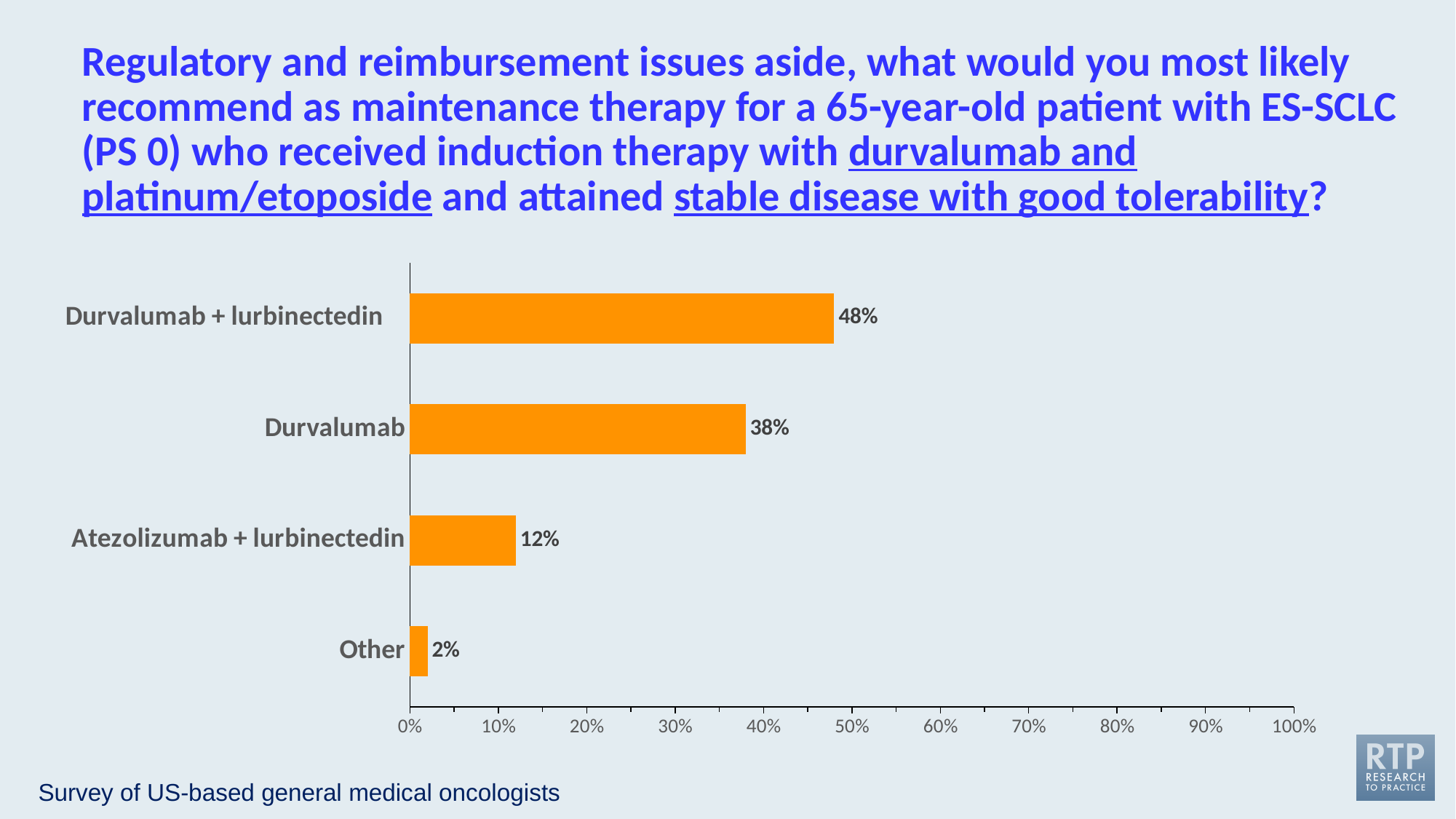
What is the difference in percentage points between Durvalumab and Atezolizumab + lurbinectedin? 26 How many answer options are shown in the chart? 4 Which option has the highest percentage of respondents? Durvalumab + lurbinectedin Which has a larger share of respondents, Durvalumab or Atezolizumab + lurbinectedin? Durvalumab What type of chart is shown on the slide? Bar chart What percentage of respondents would recommend Atezolizumab + lurbinectedin? 12% What is the difference in percentage points between Durvalumab + lurbinectedin and Durvalumab? 10 What is the maximum value shown on the horizontal axis? 100% What percentage of respondents chose Other? 2% What percentage of respondents would recommend Durvalumab alone? 38% What percentage of respondents would recommend Durvalumab + lurbinectedin? 48% Which option has the lowest percentage of respondents? Other